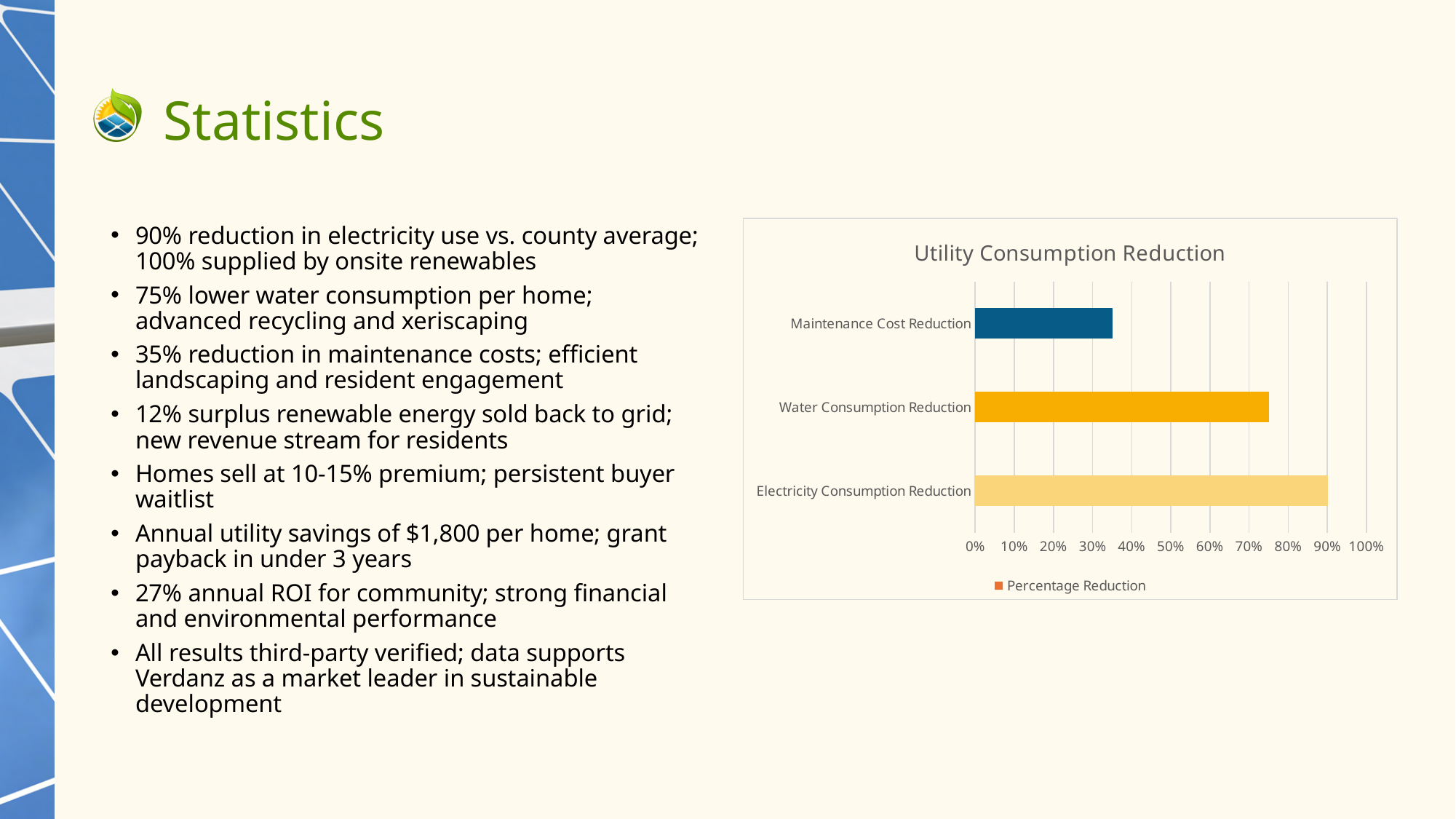
How many categories are shown in the Utility Consumption Reduction chart? 3 How many series does the legend of the Utility Consumption Reduction chart list? 1 Which category has the highest value in the Utility Consumption Reduction chart? Electricity Consumption Reduction In the Utility Consumption Reduction chart, is the value for Water Consumption Reduction greater or less than 70%? greater What is the title of the chart on the slide? Utility Consumption Reduction In the Utility Consumption Reduction chart, which is larger: Water Consumption Reduction or Maintenance Cost Reduction? Water Consumption Reduction What series name is shown in the legend of the Utility Consumption Reduction chart? Percentage Reduction In the Utility Consumption Reduction chart, is the value for Maintenance Cost Reduction greater or less than 40%? less In the Utility Consumption Reduction chart, is the value for Water Consumption Reduction greater or less than 80%? less Which category has the lowest value in the Utility Consumption Reduction chart? Maintenance Cost Reduction What is the value for Electricity Consumption Reduction in the Utility Consumption Reduction chart? 90% What kind of chart is the Utility Consumption Reduction chart? Bar chart